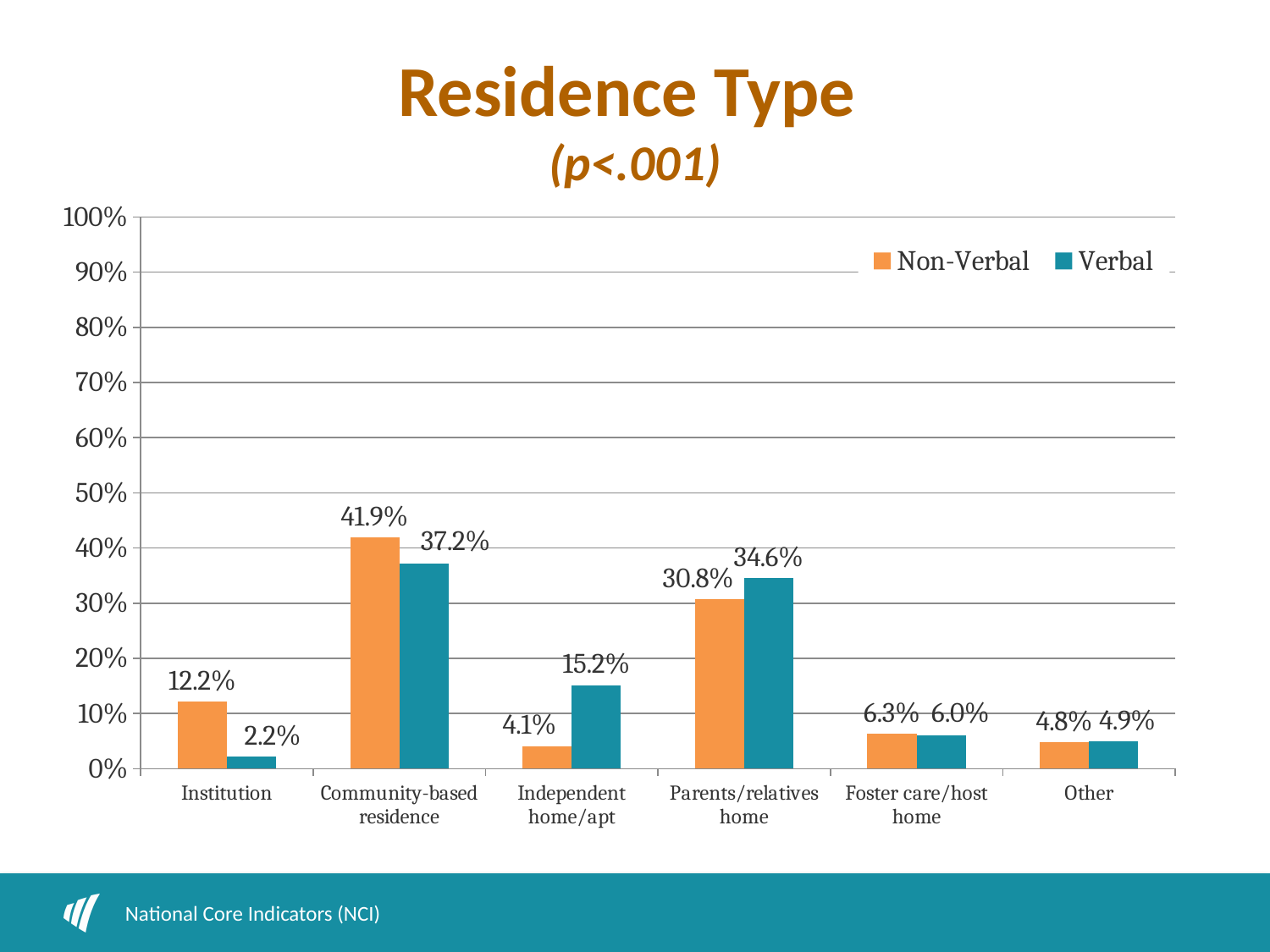
How many series does the legend list? 2 What is the Non-Verbal value for Institution? 12.2% What is the Verbal value for Parents/relatives home? 34.6% Which is larger for Independent home/apt, the Non-Verbal value or the Verbal value? Verbal Is the Non-Verbal value for Parents/relatives home greater or less than 20%? greater What kind of chart is shown on the slide? Bar chart How many residence type categories are shown on the x axis? 6 What is the Verbal value for Independent home/apt? 15.2% Which residence type has the highest Non-Verbal value? Community-based residence What is the difference between the Non-Verbal and Verbal values for Community-based residence? 4.7% Which residence type has the lowest Verbal value? Institution What is the p-value shown in the chart title? p<.001